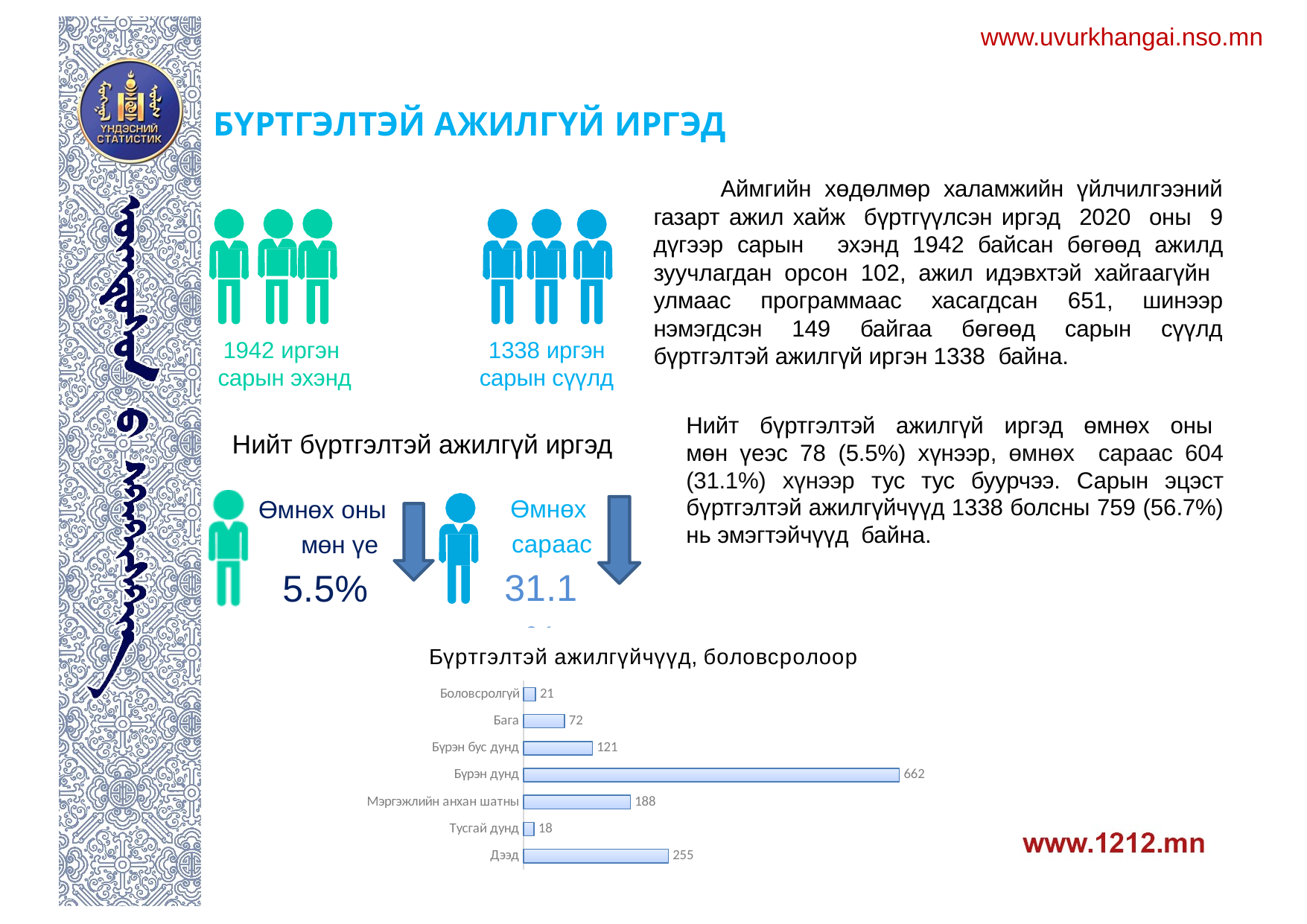
What is the title of the chart on the slide? Бүртгэлтэй ажилгүйчүүд, боловсролоор What is the difference between the values for Бүрэн бус дунд and Бага? 49 Which category has the highest value in the chart? Бүрэн дунд What is the difference between the values for Бүрэн дунд and Дээд? 407 Which is larger, the value for Мэргэжлийн анхан шатны or the value for Бүрэн бус дунд? Мэргэжлийн анхан шатны What is the value for Мэргэжлийн анхан шатны in the chart? 188 What is the value for Бүрэн дунд in the chart? 662 How many categories are shown in the chart? 7 What kind of chart is shown on the slide? Bar chart What is the value for Боловсролгүй in the chart? 21 What is the value for Дээд in the chart? 255 Which category has the lowest value in the chart? Тусгай дунд